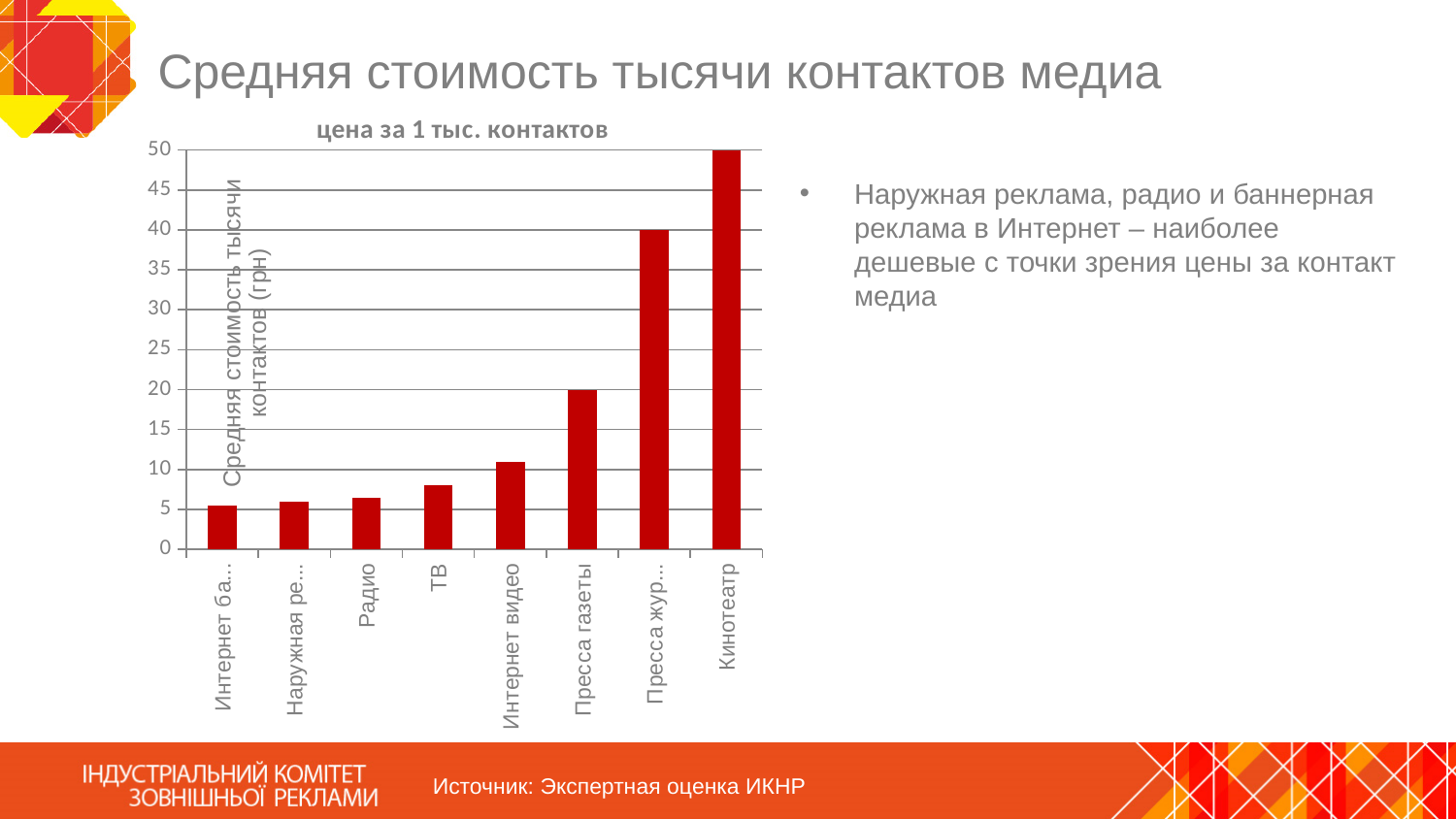
Which is larger, the value for Пресса газеты or the value for Интернет видео? Пресса газеты What kind of chart is shown on the slide? bar chart Is the value for Пресса газеты greater or less than 15? greater What is the title of the chart? цена за 1 тыс. контактов Do the values rise or fall from left to right along the x axis? rise What colour are the bars in the chart? red How many categories are plotted in the chart? 8 Is the value for Интернет видео greater or less than 10? greater Which category has the highest value in the chart? Кинотеатр Is the value for ТВ greater or less than 10? less